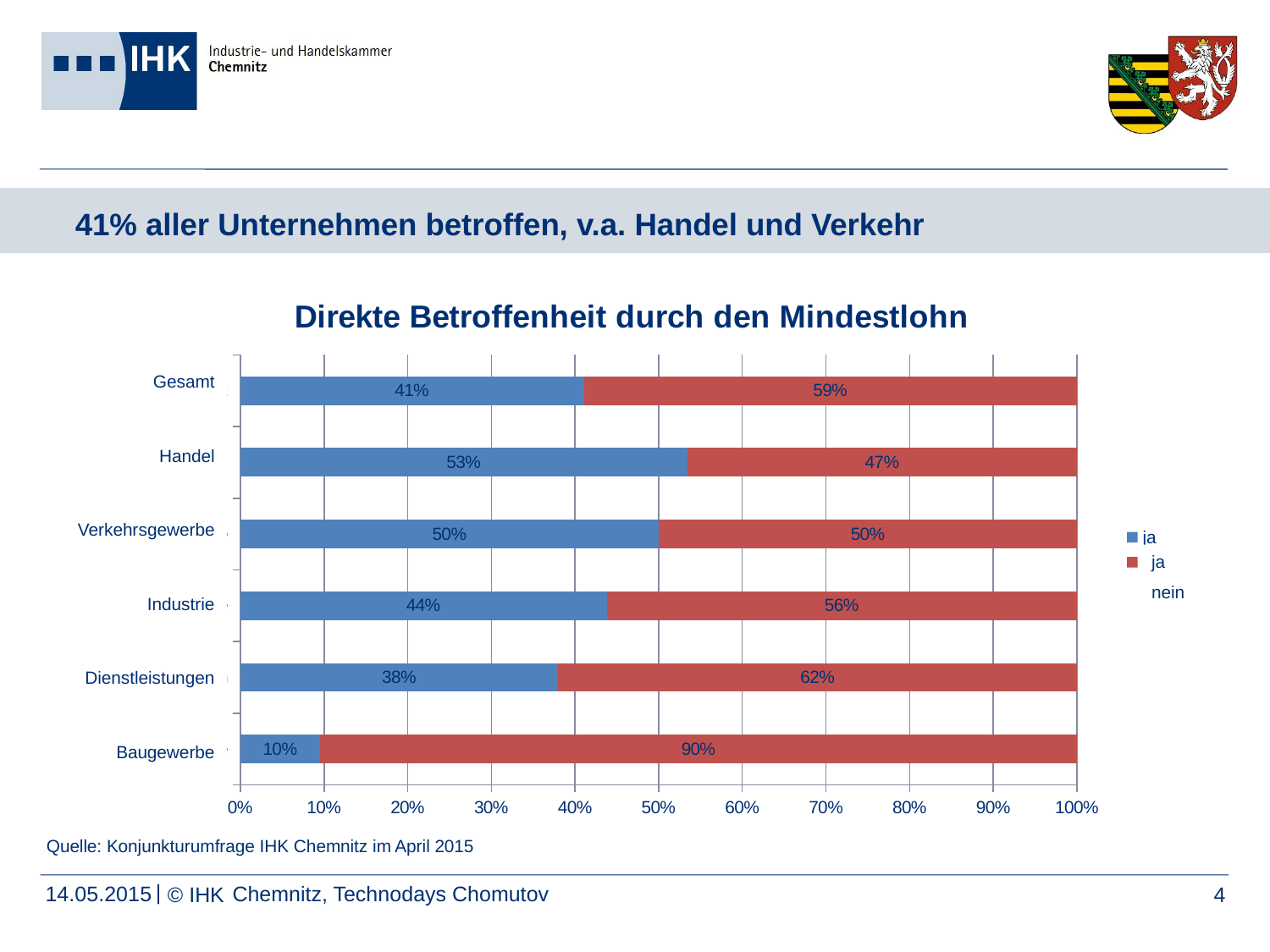
For Dienstleistungen, what is the difference between the red value and the blue value? 24 percentage points What is the value of the red segment for Baugewerbe? 90% What is the value of the blue 'ja' segment for Handel? 53% Which category has the largest red segment? Baugewerbe Which has a larger blue 'ja' value: Industrie or Verkehrsgewerbe? Verkehrsgewerbe How many categories are shown on the y axis of the chart? 6 Which category has the highest 'ja' (blue) value? Handel What type of chart is shown on the slide? Stacked bar chart What is the 'ja' value for Gesamt? 41% What is the red 'nein' value for Industrie? 56% What is the title of the chart? Direkte Betroffenheit durch den Mindestlohn Which category has the lowest 'ja' (blue) value? Baugewerbe